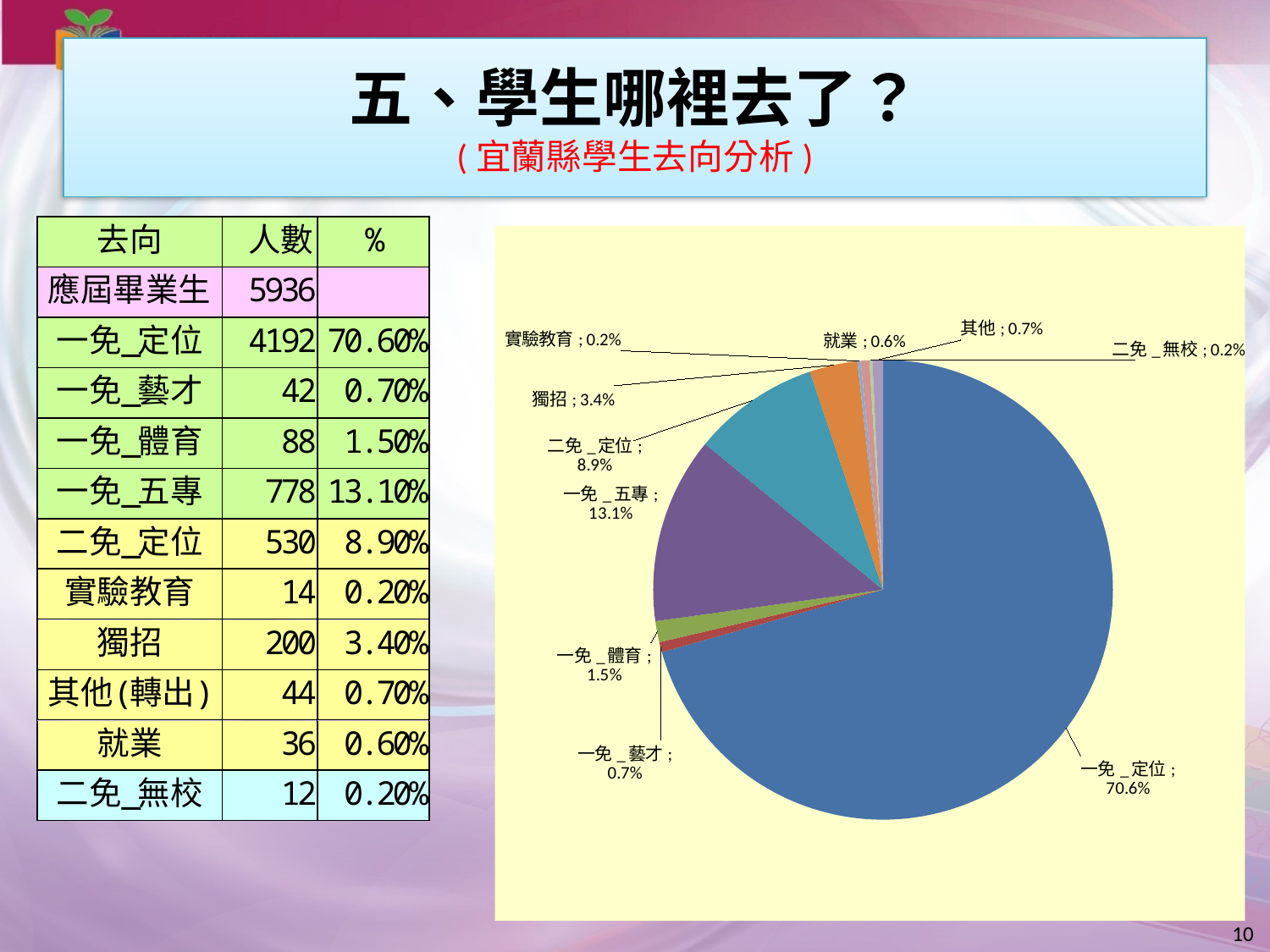
What is the difference in percentage points between the 一免_定位 slice and the 一免_五專 slice? 57.5% What percentage does the 一免_定位 slice show in the pie chart? 70.6% What percentage does the 二免_定位 slice show in the pie chart? 8.9% What share of the pie does 一免_體育 take? 1.5% What percentage does the 獨招 slice show in the pie chart? 3.4% What share of the pie does 就業 take? 0.6% Which slice is larger in the pie chart, 獨招 or 一免_體育? 獨招 What kind of chart is shown on the slide? pie chart What percentage does the 一免_五專 slice show in the pie chart? 13.1% How many slices does the pie chart have? 10 What is the difference in percentage points between the 一免_五專 slice and the 二免_定位 slice? 4.2% Which category has the largest slice in the pie chart? 一免_定位